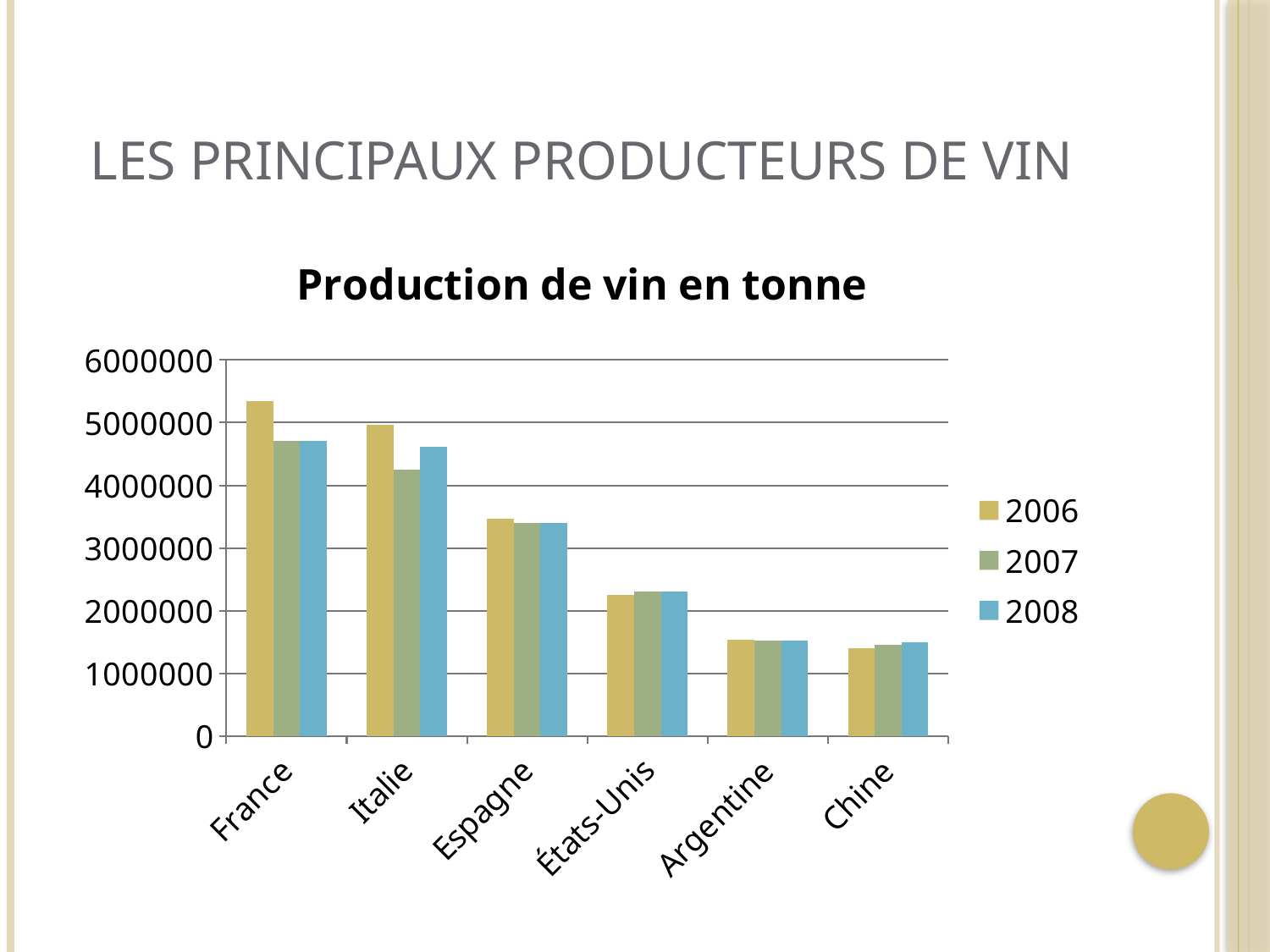
Is the 2007 value for Italie greater or less than 4000000? greater For Italie, which is larger, the 2007 value or the 2008 value? 2008 What kind of chart is shown on the slide? bar chart Which is larger, the 2006 value for France or the 2006 value for Italie? France Which country has the highest 2006 bar? France Is the 2008 value for Espagne greater or less than 4000000? less Is the 2006 value for France greater or less than 5000000? greater How many series does the legend list? 3 Which country has the lowest 2006 bar? Chine How many countries are shown on the x axis of the chart? 6 Do the 2006 values rise or fall moving from France to Chine along the x axis? fall